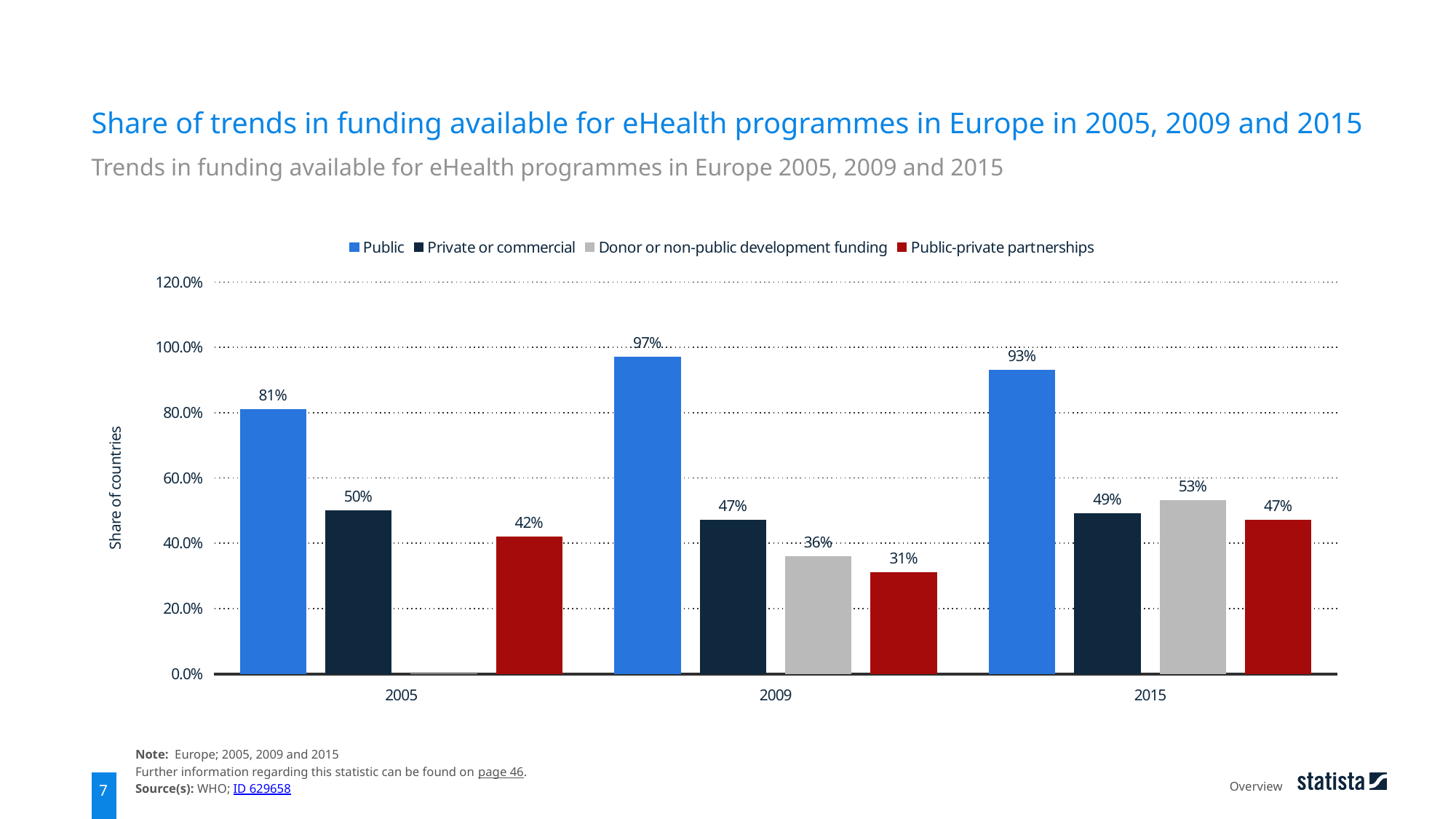
What is the value for Donor or non-public development funding in 2015? 53% What is the label of the y axis? Share of countries What is the difference between the Public share in 2009 and the Public share in 2005? 16% How many series does the legend list? 4 What is the value for Public-private partnerships in 2005? 42% How many years are shown on the x axis? 3 What is the value for Public funding in 2009? 97% In which year is the Public-private partnerships share lowest? 2009 In which year is the Public funding share highest? 2009 What kind of chart is shown on the slide? Bar chart Is the value for Public-private partnerships in 2009 greater or less than 40.0%? less Which is larger in 2015: Private or commercial or Donor or non-public development funding? Donor or non-public development funding